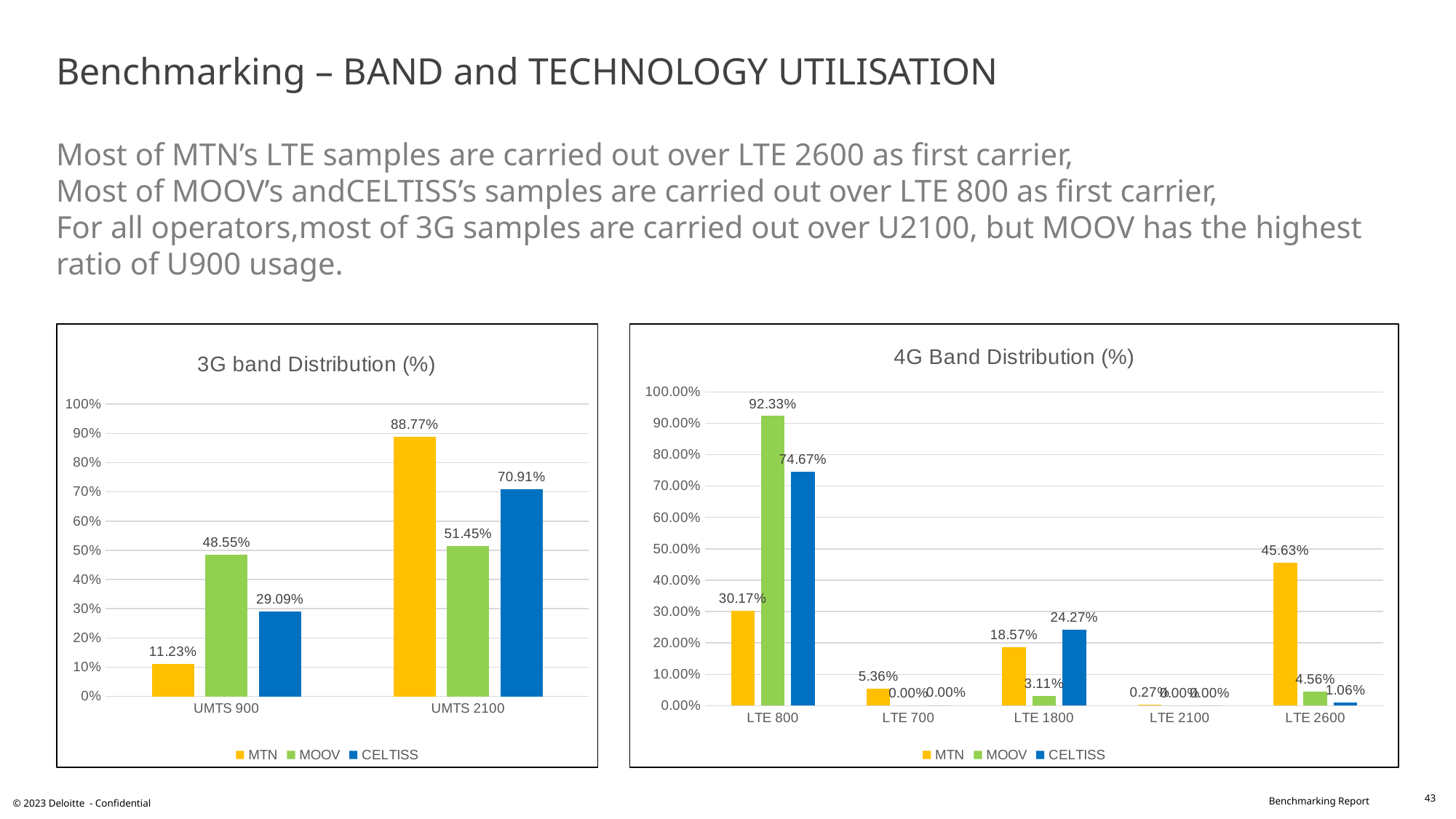
In the 4G Band Distribution (%) chart, what is the difference between MOOV and CELTISS at LTE 800? 17.66% In the 3G band Distribution (%) chart, which operator has the highest value at UMTS 2100? MTN In the 4G Band Distribution (%) chart, what is the value for CELTISS at LTE 1800? 24.27% In the 4G Band Distribution (%) chart, what is the value for MOOV at LTE 800? 92.33% In the 3G band Distribution (%) chart, what is the value for MTN at UMTS 2100? 88.77% In the 3G band Distribution (%) chart, how many series does the legend list? 3 In the 3G band Distribution (%) chart, what is the value for MOOV at UMTS 900? 48.55% In the 4G Band Distribution (%) chart, how many LTE band categories are shown on the x axis? 5 What type of chart is the 4G Band Distribution (%) chart? Bar chart In the 4G Band Distribution (%) chart, which operator has the highest value at LTE 2600? MTN In the 4G Band Distribution (%) chart, which is larger: MTN at LTE 800 or MTN at LTE 2600? MTN at LTE 2600 In the 3G band Distribution (%) chart, what is the difference between CELTISS at UMTS 2100 and CELTISS at UMTS 900? 41.82%